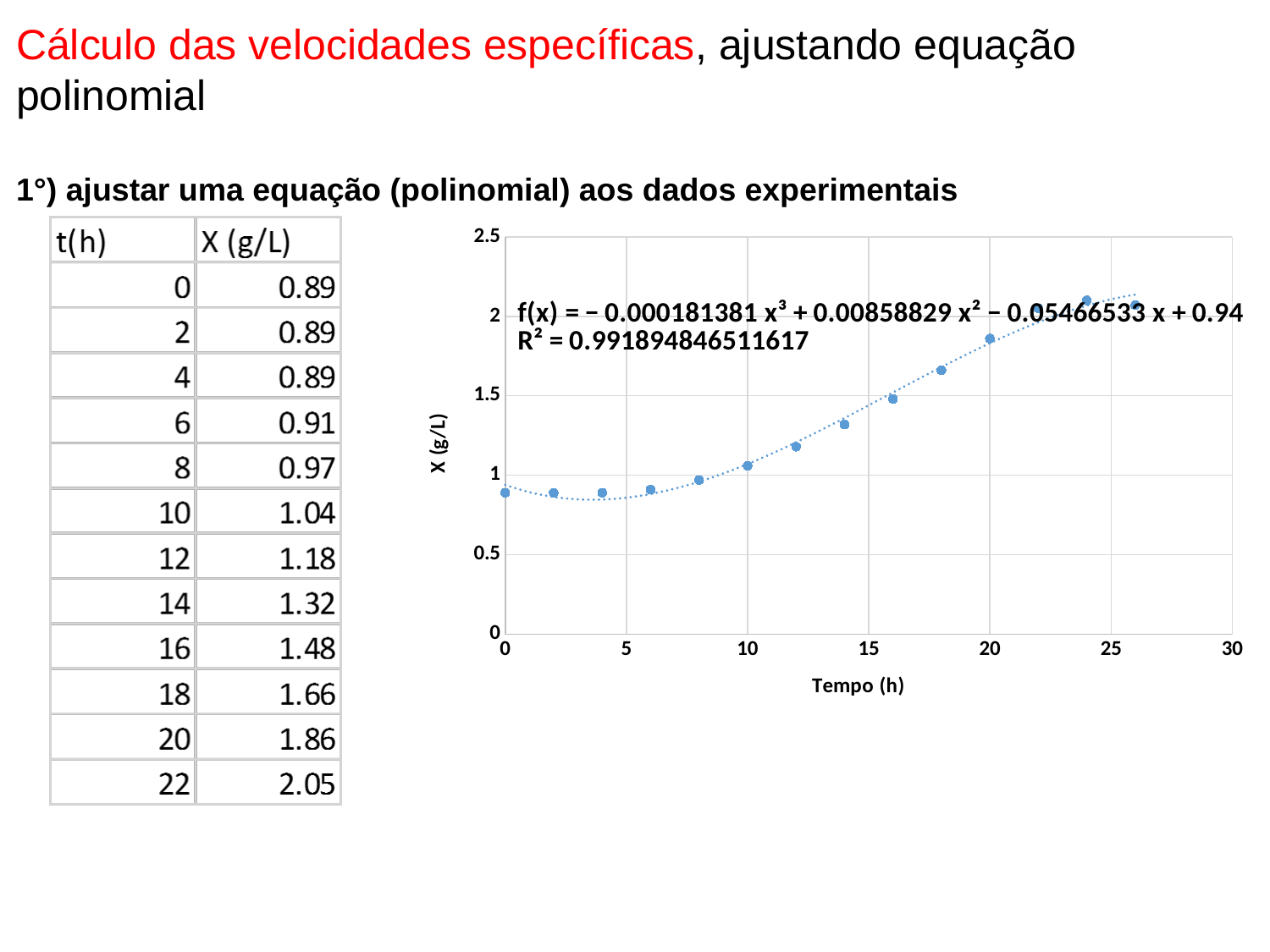
According to the table on the slide, what is X (g/L) at t = 22 h? 2.05 According to the table on the slide, what is X (g/L) at t = 12 h? 1.18 What R² value is printed on the chart? 0.991894846511617 What kind of chart is shown on the slide? scatter chart Is the plotted value at Tempo = 4 h greater or less than 1? less Is the plotted value at Tempo = 14 h greater or less than 1.5? less Do the plotted X (g/L) values generally rise or fall as Tempo (h) increases? rise Which plotted point is higher: the one at Tempo = 8 h or the one at Tempo = 18 h? Tempo = 18 h What is the highest tick value shown on the y axis of the chart? 2.5 What is the title of the x axis of the chart? Tempo (h) Is the plotted value at Tempo = 20 h greater or less than 1.5? greater